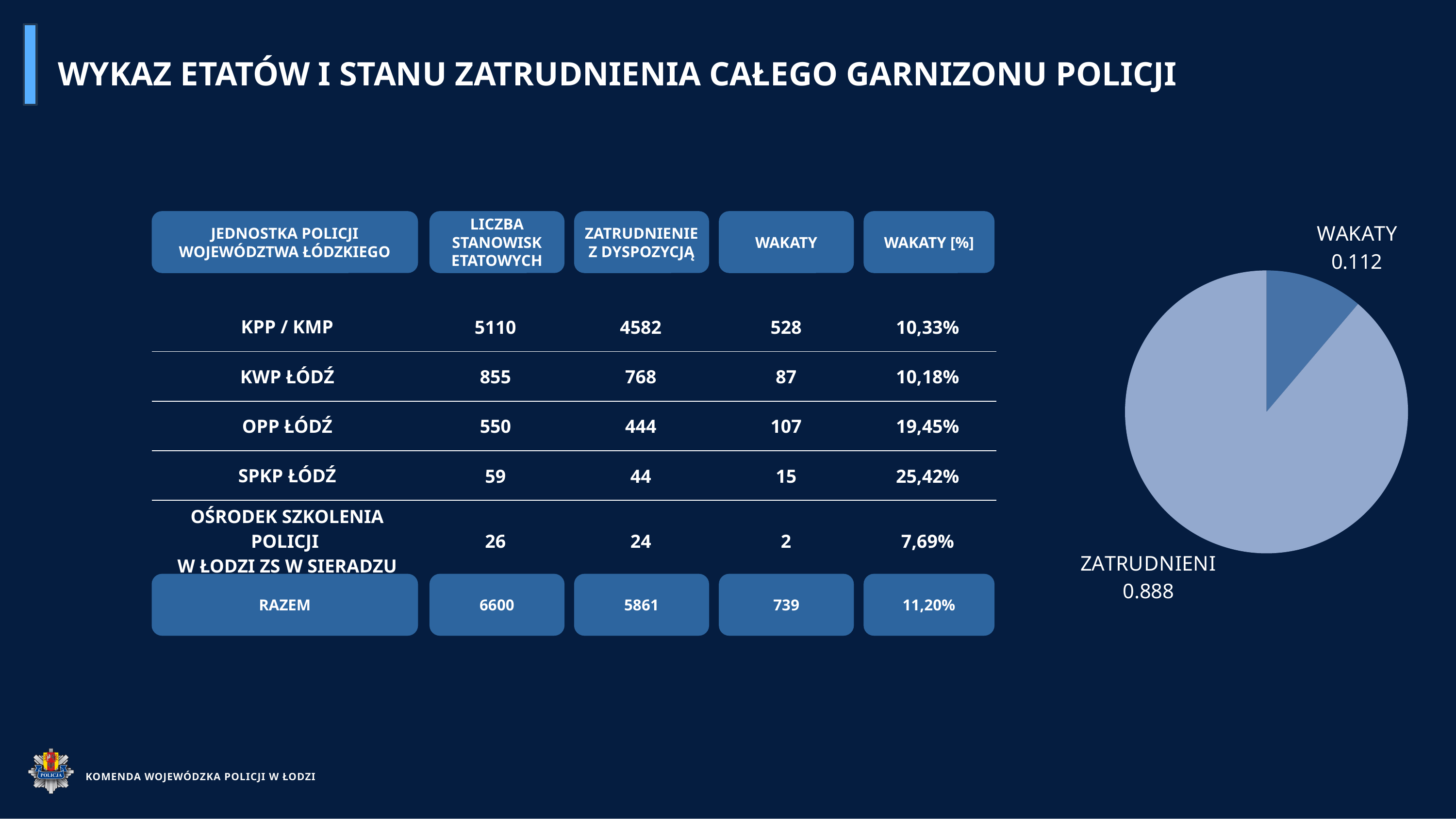
What kind of chart is shown on the right side of the slide? pie chart Which slice of the pie chart is drawn in the darker blue colour? WAKATY In the pie chart, which is larger: WAKATY or ZATRUDNIENI? ZATRUDNIENI How many slices does the pie chart have? 2 What share of the pie chart does the WAKATY slice represent? 0.112 What value is shown for the ZATRUDNIENI slice of the pie chart? 0.888 What is the difference between the ZATRUDNIENI and WAKATY values in the pie chart? 0.776 Which slice of the pie chart is the largest? ZATRUDNIENI What are the two category labels shown on the pie chart? WAKATY and ZATRUDNIENI What share of the pie chart does the ZATRUDNIENI slice represent? 0.888 Which slice of the pie chart is the smallest? WAKATY What value is shown for the WAKATY slice of the pie chart? 0.112